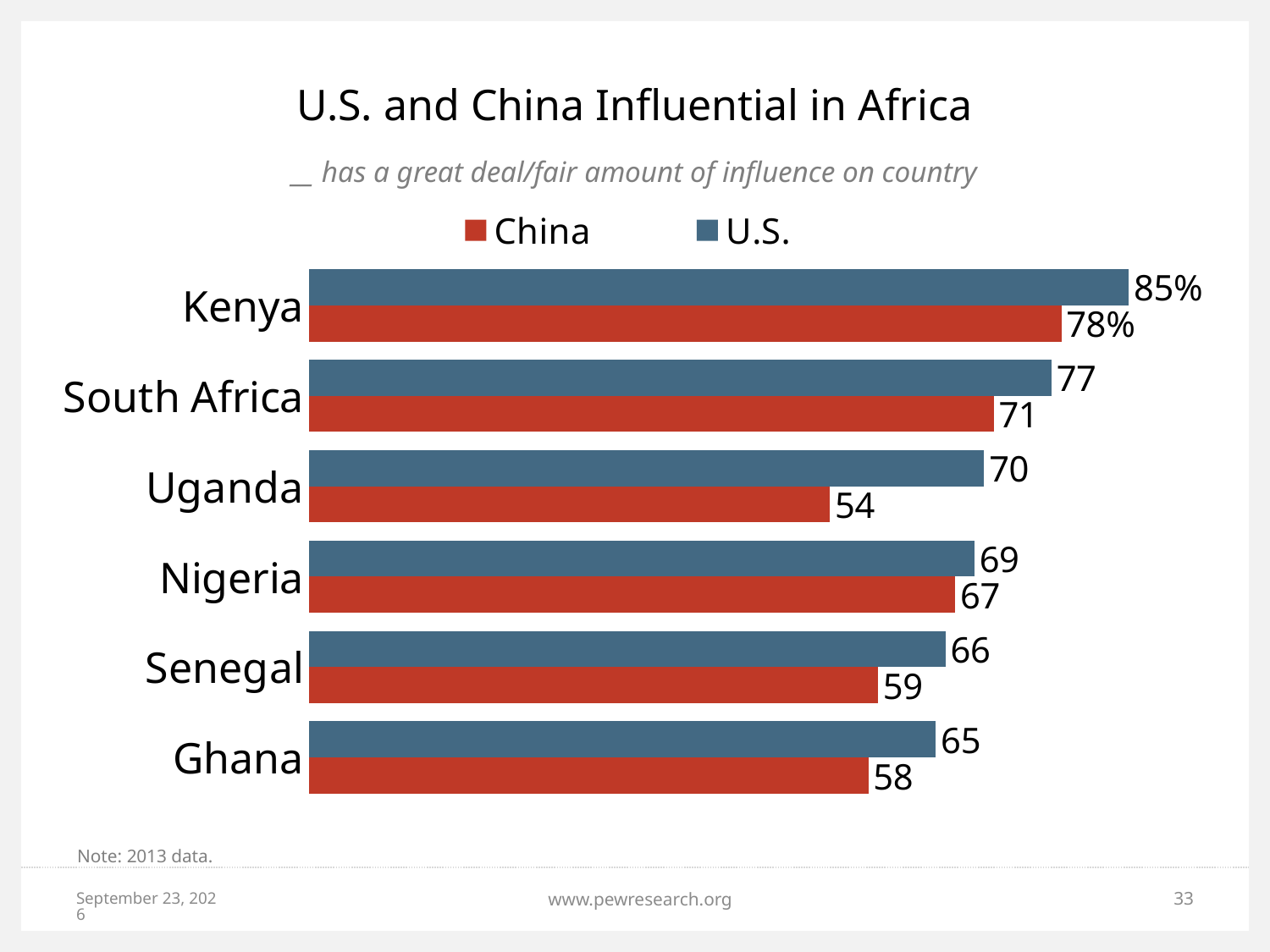
What is the difference between the U.S. values for Kenya and South Africa? 8 What kind of chart is shown on the slide? Bar chart What is the difference between the U.S. and China values for Uganda? 16 Which is larger in Senegal, the value for China or the value for the U.S.? U.S. How many countries are shown in the chart? 6 Which colour represents China in the chart? Red What percentage of Kenyans say the U.S. has a great deal/fair amount of influence on their country? 85% What is the value for the U.S. in Ghana? 65 Which country has the lowest value for the U.S.? Ghana How many series does the legend list? 2 What is the value for China in Uganda? 54 Which country has the highest value for China? Kenya